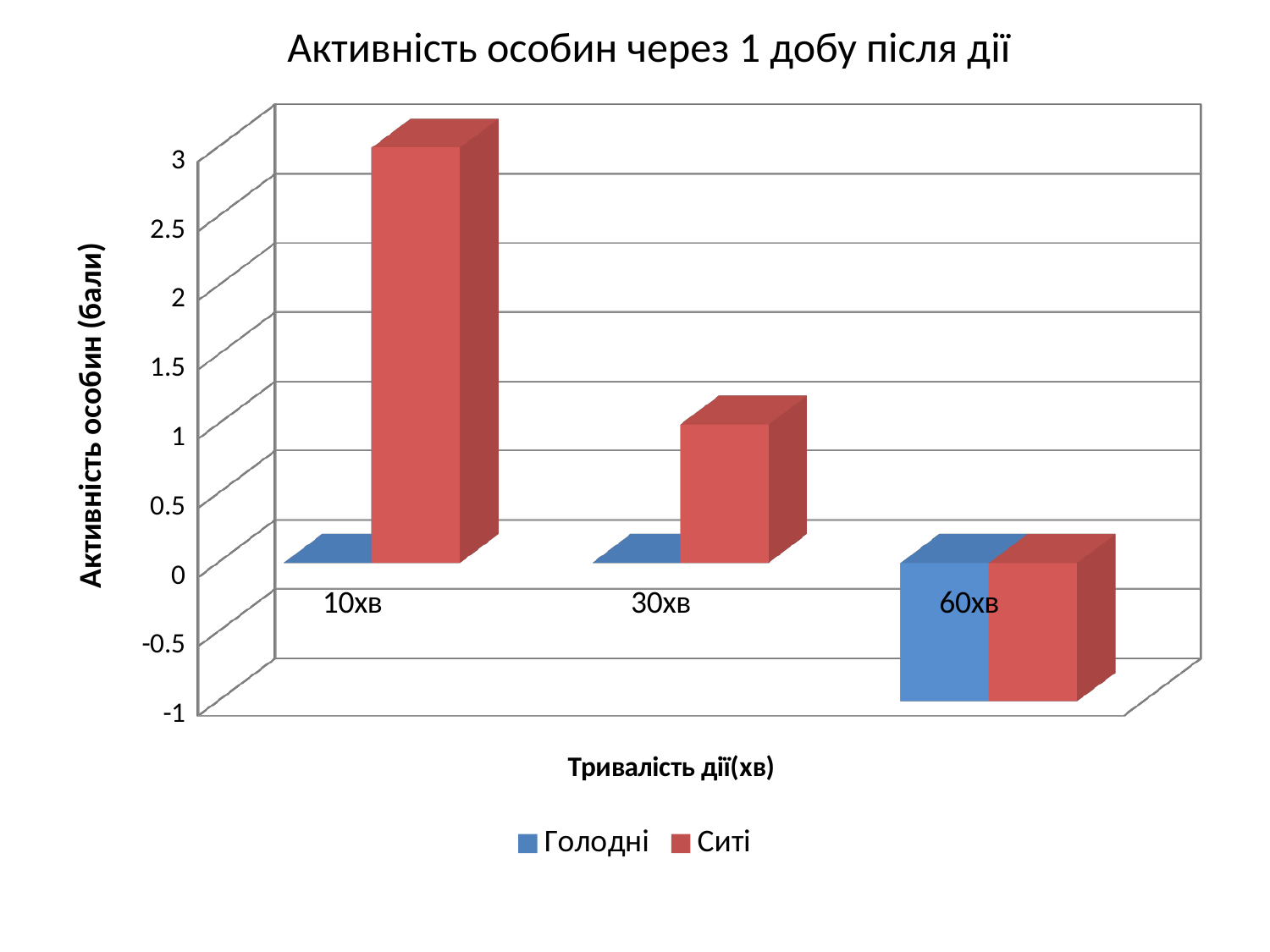
How many series does the legend list? 2 At which category is the value for Ситі lowest? 60хв What is the value for Голодні at 60хв? -1 At which category is the value for Ситі highest? 10хв How many categories are shown on the x axis? 3 Which series is shown in red? Ситі What kind of chart is shown on the slide? bar chart What is the title of the chart? Активність особин через 1 добу після дії Do the values for Ситі rise or fall from 10хв to 60хв? fall What is the value for Ситі at 10хв? 3 What is the value for Ситі at 30хв? 1 Is the value for Ситі at 10хв greater or less than 2? greater